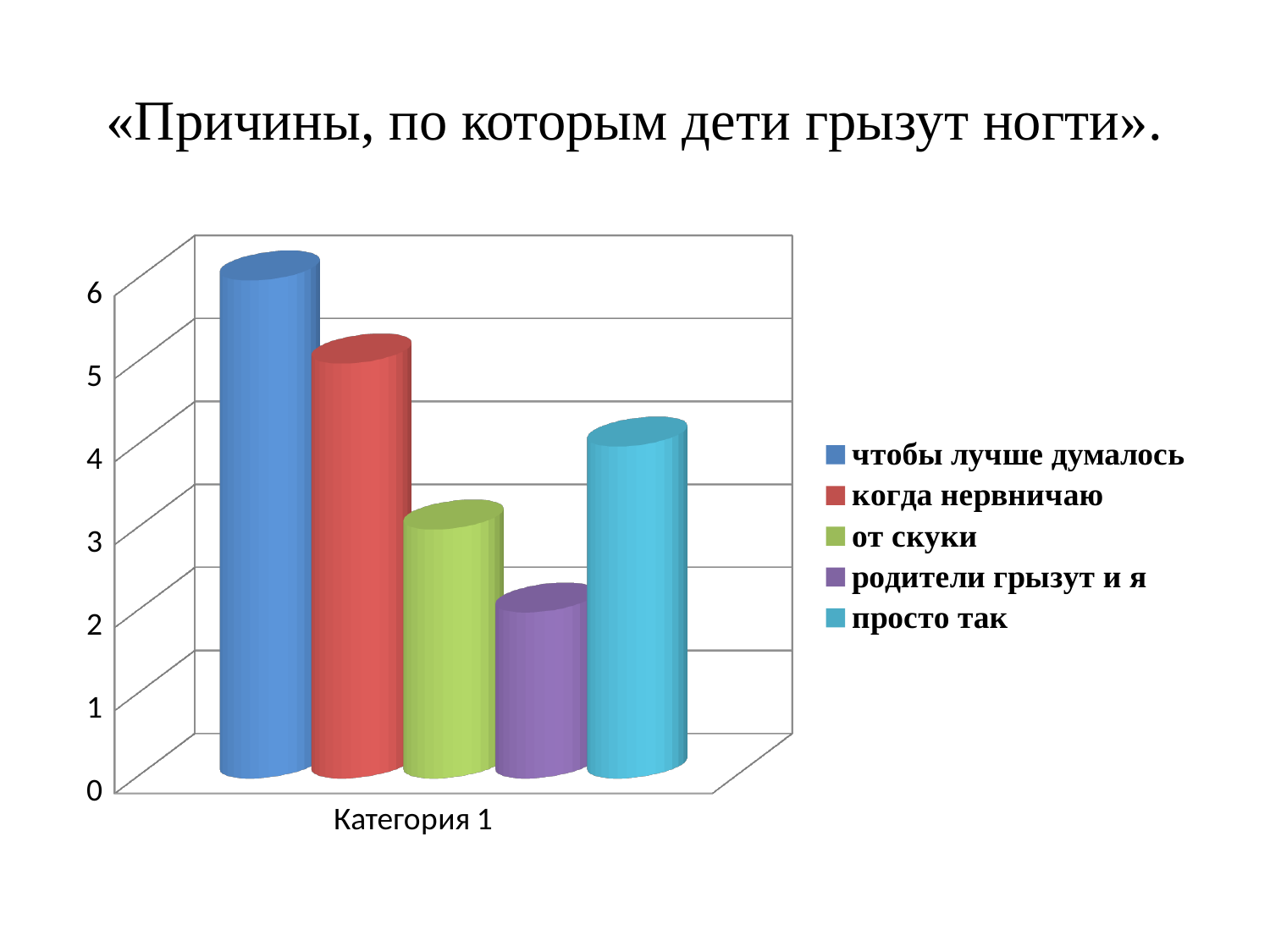
Is the value for "родители грызут и я" greater or less than 3? less Which series has the lowest value? родители грызут и я Is the value for "просто так" greater or less than 3? greater Which is larger, the value for "когда нервничаю" or the value for "просто так"? когда нервничаю Which series has the highest value? чтобы лучше думалось Is the value for "когда нервничаю" greater or less than 4? greater What is the title of the slide? «Причины, по которым дети грызут ногти». What kind of chart is shown on the slide? bar chart How many series does the legend list? 5 Which is larger, the value for "от скуки" or the value for "просто так"? просто так